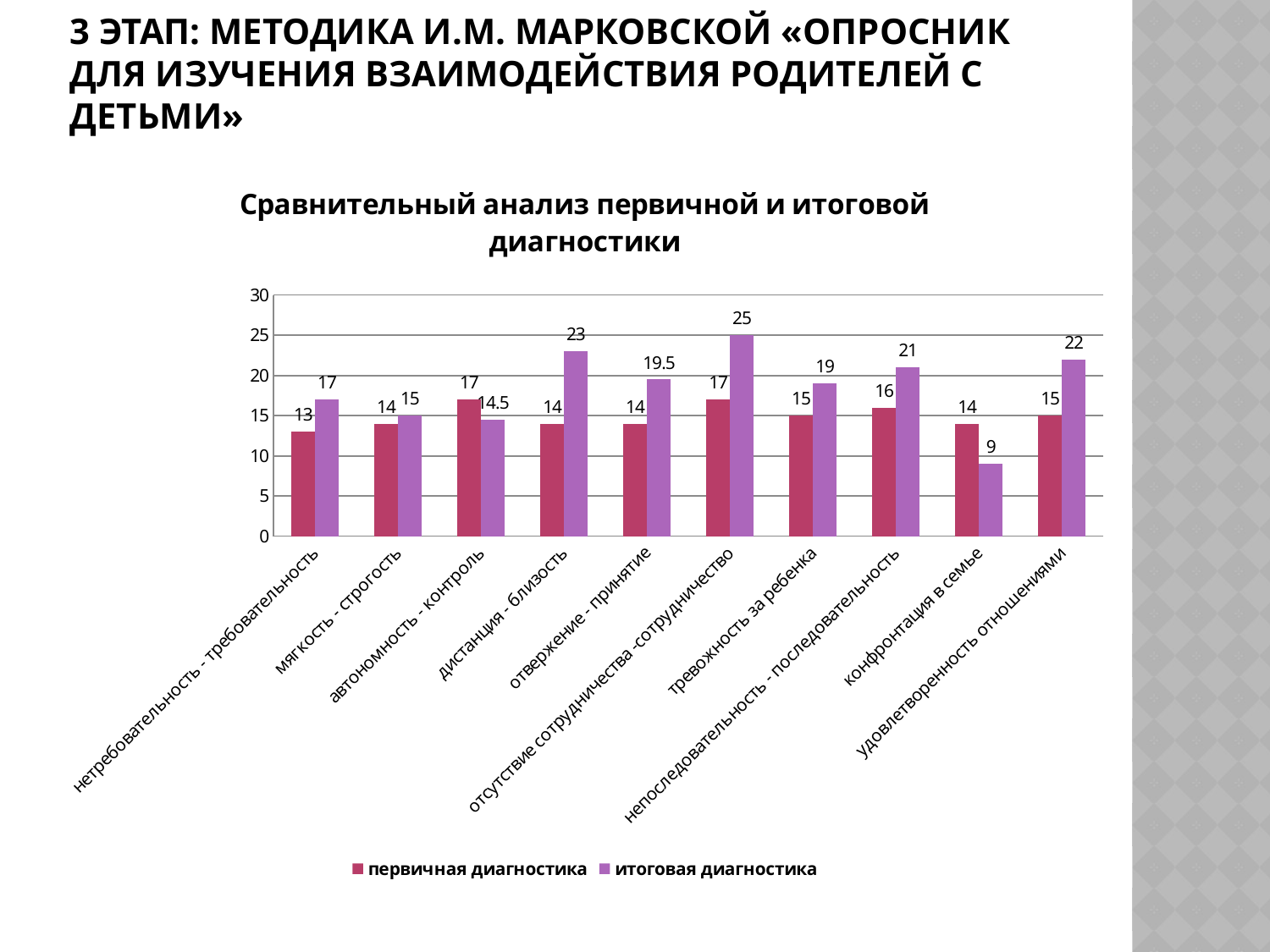
What is the value of первичная диагностика for непоследовательность - последовательность? 16 What kind of chart is shown on the slide? bar chart What is the title of the chart? Сравнительный анализ первичной и итоговой диагностики Is the value of итоговая диагностика for конфронтация в семье greater or less than 10? less What is the value of итоговая диагностика for дистанция - близость? 23 Which category has the lowest value for итоговая диагностика? конфронтация в семье How many series does the legend list? 2 What is the value of итоговая диагностика for отвержение - принятие? 19.5 Which category has the highest value for итоговая диагностика? отсутствие сотрудничества - сотрудничество For автономность - контроль, which is larger: первичная диагностика or итоговая диагностика? первичная диагностика What is the difference between итоговая диагностика and первичная диагностика for удовлетворенность отношениями? 7 How many categories are shown on the x axis? 10